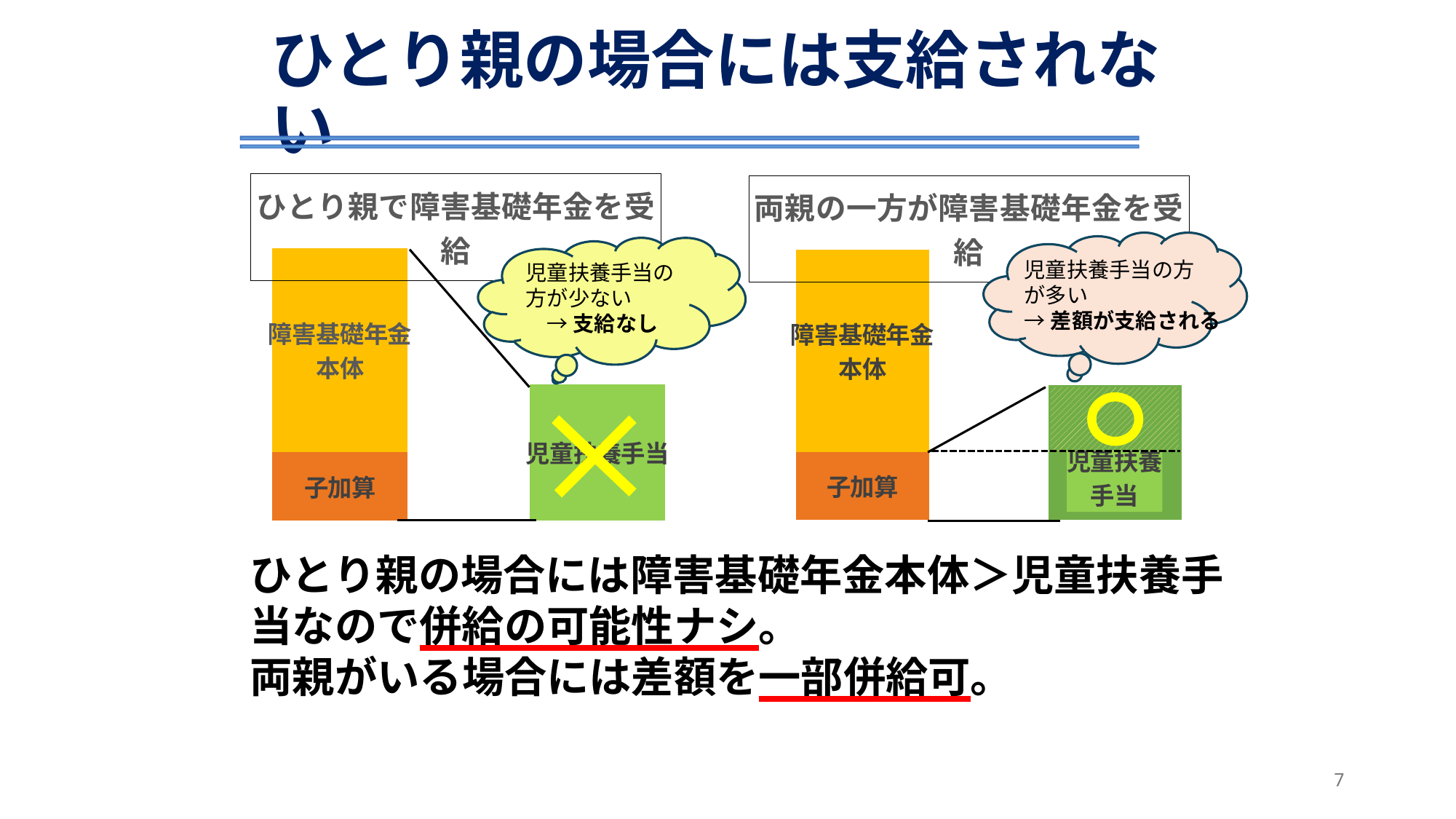
In the left diagram, what are the two segments of the stacked pension bar labelled? 障害基礎年金本体 and 子加算 In the left diagram, how many segments make up the stacked pension bar? 2 In the left diagram (ひとり親で障害基礎年金を受給), which is taller: the 障害基礎年金本体 bar or the 児童扶養手当 bar? 障害基礎年金本体 What kind of diagram is used on this slide to compare the benefits? Bar chart In the left diagram, what symbol is drawn on the 児童扶養手当 bar? A yellow cross (×) In the right diagram, what symbol is drawn on the 児童扶養手当 bar? A yellow circle (○) In the right diagram (両親の一方が障害基礎年金を受給), which is taller: the 児童扶養手当 bar or the 子加算 segment? 児童扶養手当